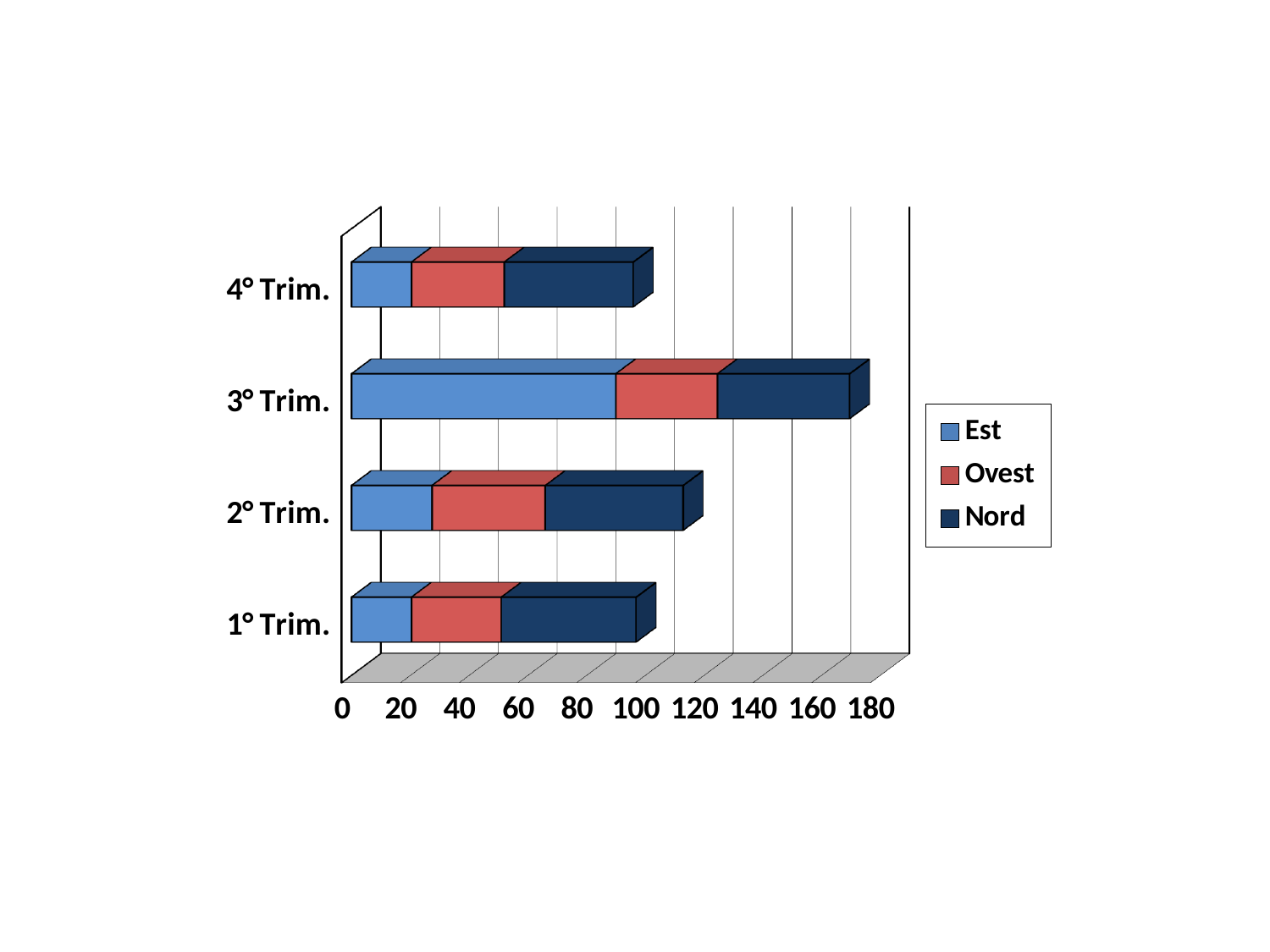
Is the Est value larger for 3° Trim. or for 1° Trim.? 3° Trim. Is the Est value for 1° Trim. greater or less than 40? less Is the total value for 1° Trim. greater or less than 120? less How many categories are shown on the vertical axis? 4 What colour represents the Nord series? dark blue Which series are listed in the legend? Est, Ovest, Nord Is the total value for 3° Trim. greater or less than 140? greater What kind of chart is shown on the slide? stacked bar chart How many series does the legend list? 3 Which category has the longest total bar? 3° Trim. Which category has the longest Est segment? 3° Trim.